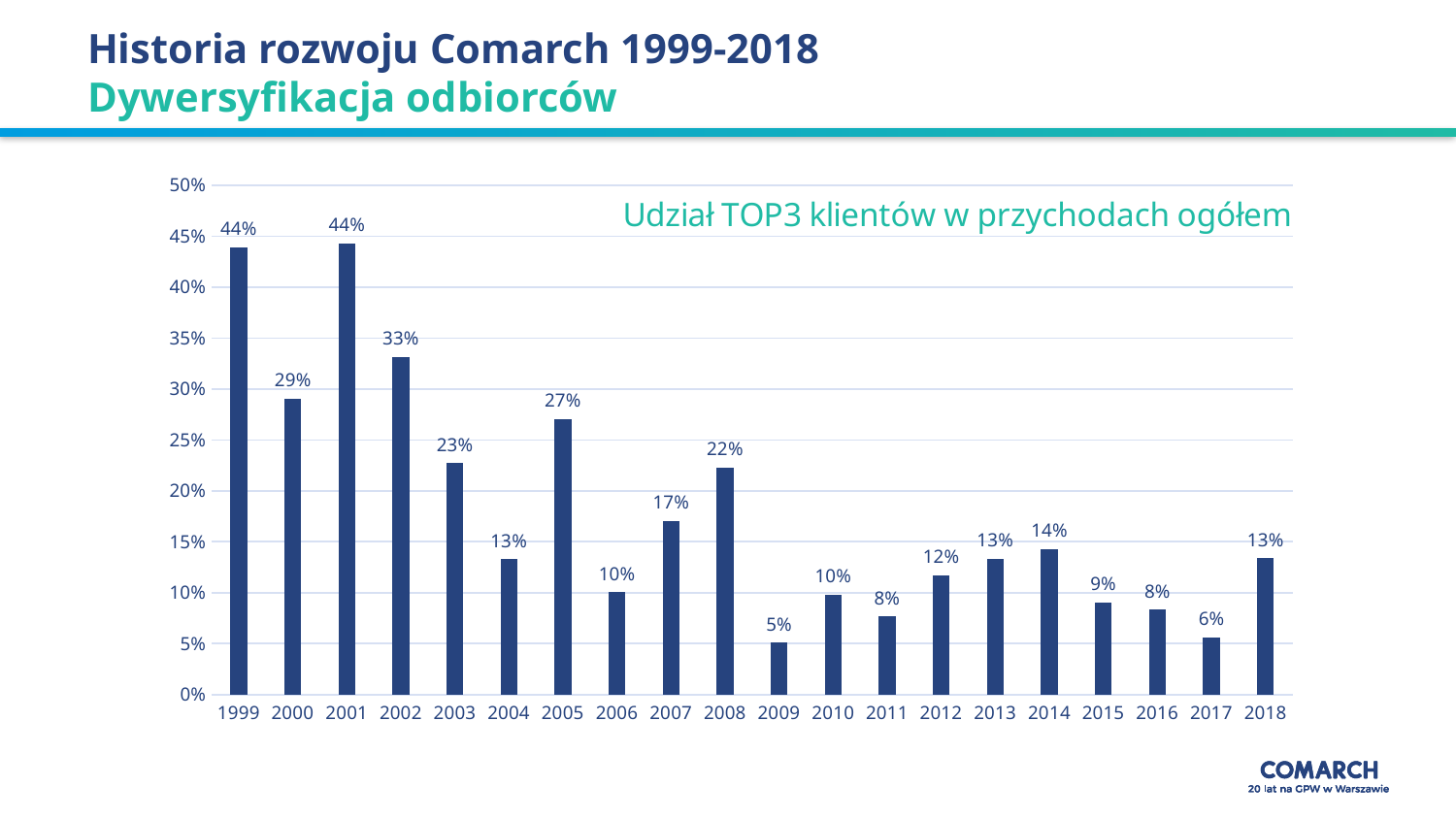
Which is larger, the value for 2014 or the value for 2017? 2014 Which year has the lowest value? 2009 How many years are shown on the x axis? 20 Do the values generally rise or fall from 1999 to 2018? fall What is the title of the chart? Udział TOP3 klientów w przychodach ogółem What is the value for 2009? 5% What is the difference between the values for 2005 and 2006? 17% What is the difference between the values for 1999 and 2000? 15% Which is larger, the value for 2002 or the value for 2005? 2002 What is the value for 2003? 23% What is the value for 2018? 13% What type of chart is shown on the slide? bar chart